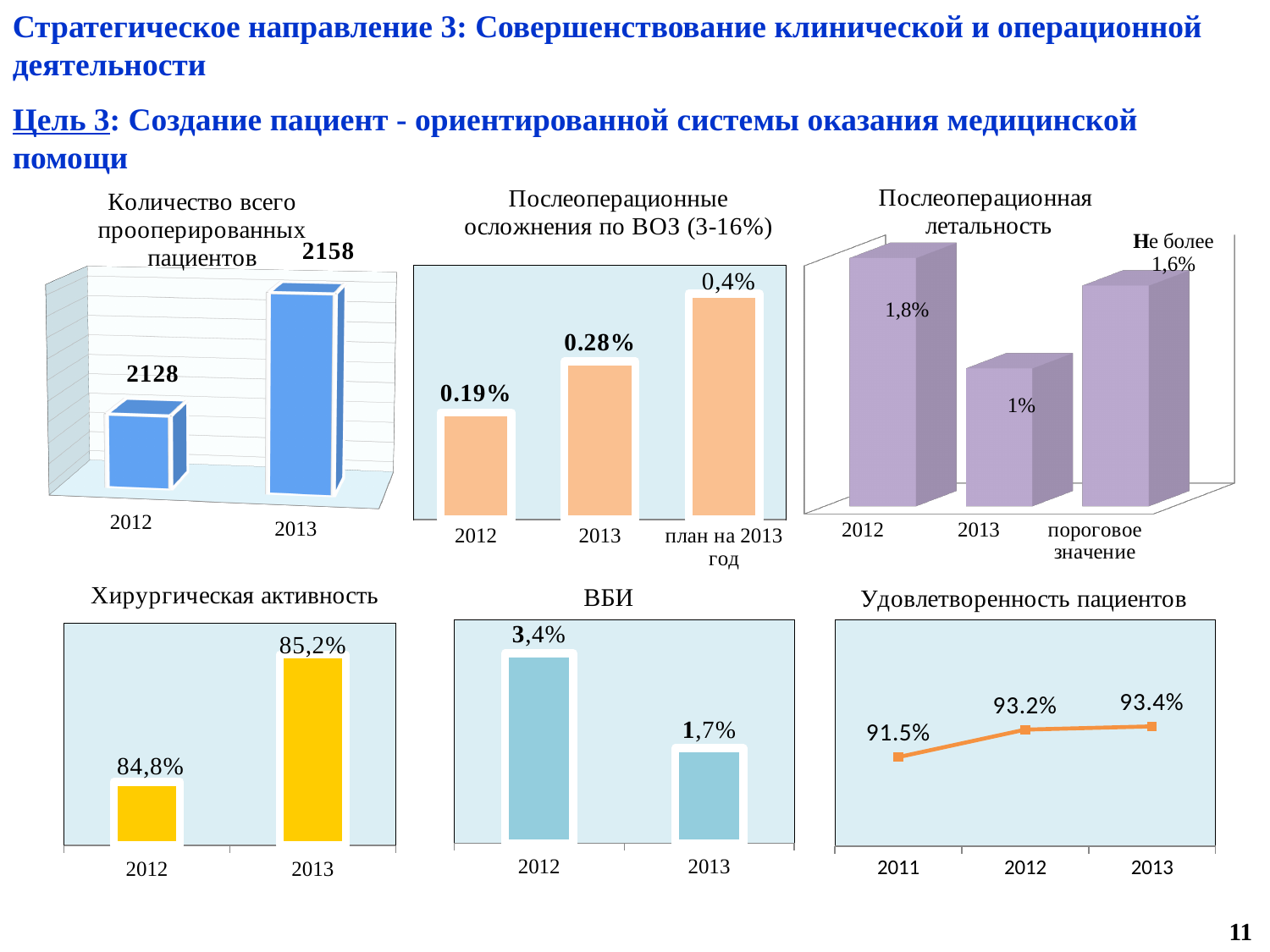
In the chart 'ВБИ', do the values rise or fall from 2012 to 2013? fall In the chart 'Количество всего прооперированных пациентов', what is the difference between the 2013 and 2012 values? 30 In the chart 'Количество всего прооперированных пациентов', what is the value for 2013? 2158 In the chart 'Удовлетворенность пациентов', how many data points are plotted? 3 In the chart 'Послеоперационная летальность', what is the value for 2013? 1% In the chart 'Послеоперационные осложнения по ВОЗ (3-16%)', which category has the highest value? план на 2013 год In the chart 'Хирургическая активность', what is the value for 2012? 84,8% In the chart 'Послеоперационные осложнения по ВОЗ (3-16%)', what is the value for 2012? 0.19% In the chart 'Хирургическая активность', what is the difference between the 2013 and 2012 values? 0,4% In the chart 'Послеоперационная летальность', which year has the larger value, 2012 or 2013? 2012 What kind of chart is 'Удовлетворенность пациентов'? line chart In the chart 'ВБИ', what is the value for 2013? 1,7%